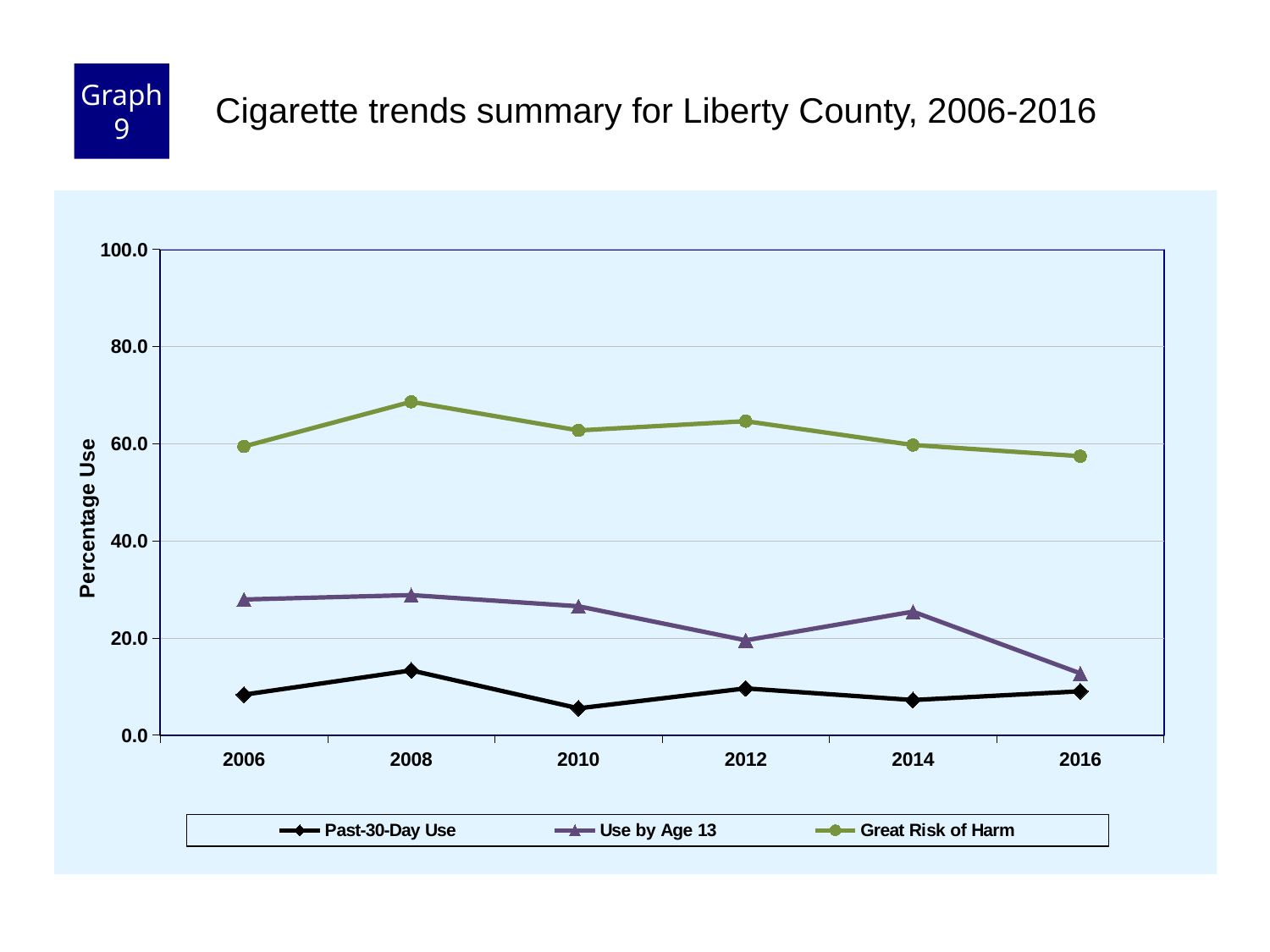
In which year is the Great Risk of Harm series at its highest? 2008 Is the value for Use by Age 13 in 2016 greater or less than 20.0? less How many series does the legend list? 3 What is the label on the y axis? Percentage Use In 2012, which series has the larger value: Great Risk of Harm or Use by Age 13? Great Risk of Harm What kind of chart is shown on the slide? line chart Is the value for Great Risk of Harm in 2016 greater or less than 60.0? less In which year is the Past-30-Day Use series at its lowest? 2010 In which year is the Past-30-Day Use series at its highest? 2008 How many years are plotted along the x axis? 6 In which year is the Use by Age 13 series at its lowest? 2016 Does the Great Risk of Harm series rise or fall from 2008 to 2016? fall